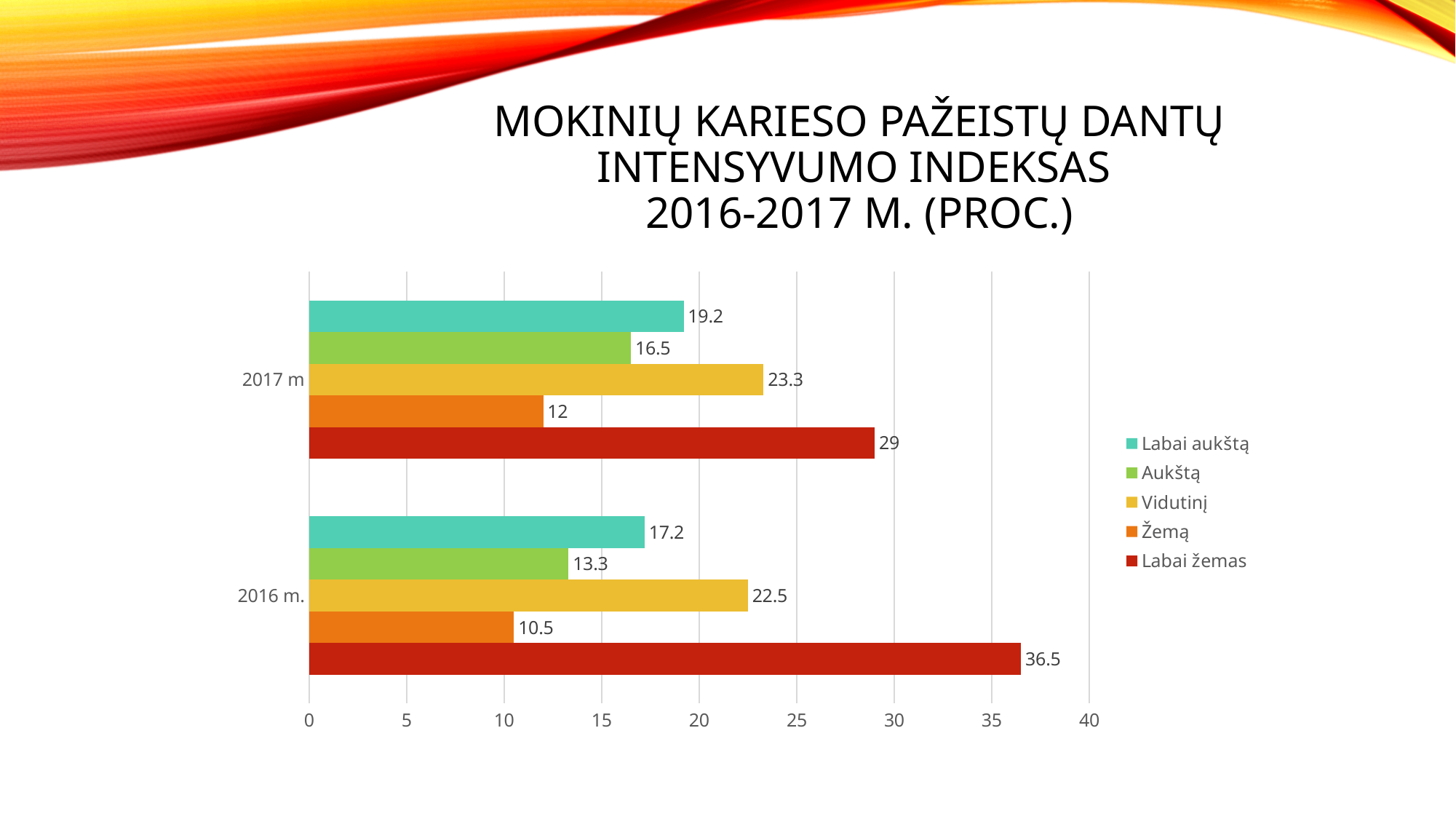
What is the difference between the Labai žemas values for 2016 m. and 2017 m? 7.5 How many series does the legend list? 5 What colour represents the Vidutinį series in the legend? Yellow Is the value for Aukštą in 2016 m. greater or less than 15? less What is the value for Vidutinį in 2017 m? 23.3 Which series has the highest value in 2017 m? Labai žemas Which is larger: Labai aukštą in 2017 m or Labai aukštą in 2016 m.? Labai aukštą in 2017 m Which series has the lowest value in 2016 m.? Žemą How many categories are shown on the vertical axis? 2 What is the value for Žemą in 2016 m.? 10.5 What is the value for Labai žemas in 2016 m.? 36.5 What kind of chart is shown on the slide? Bar chart